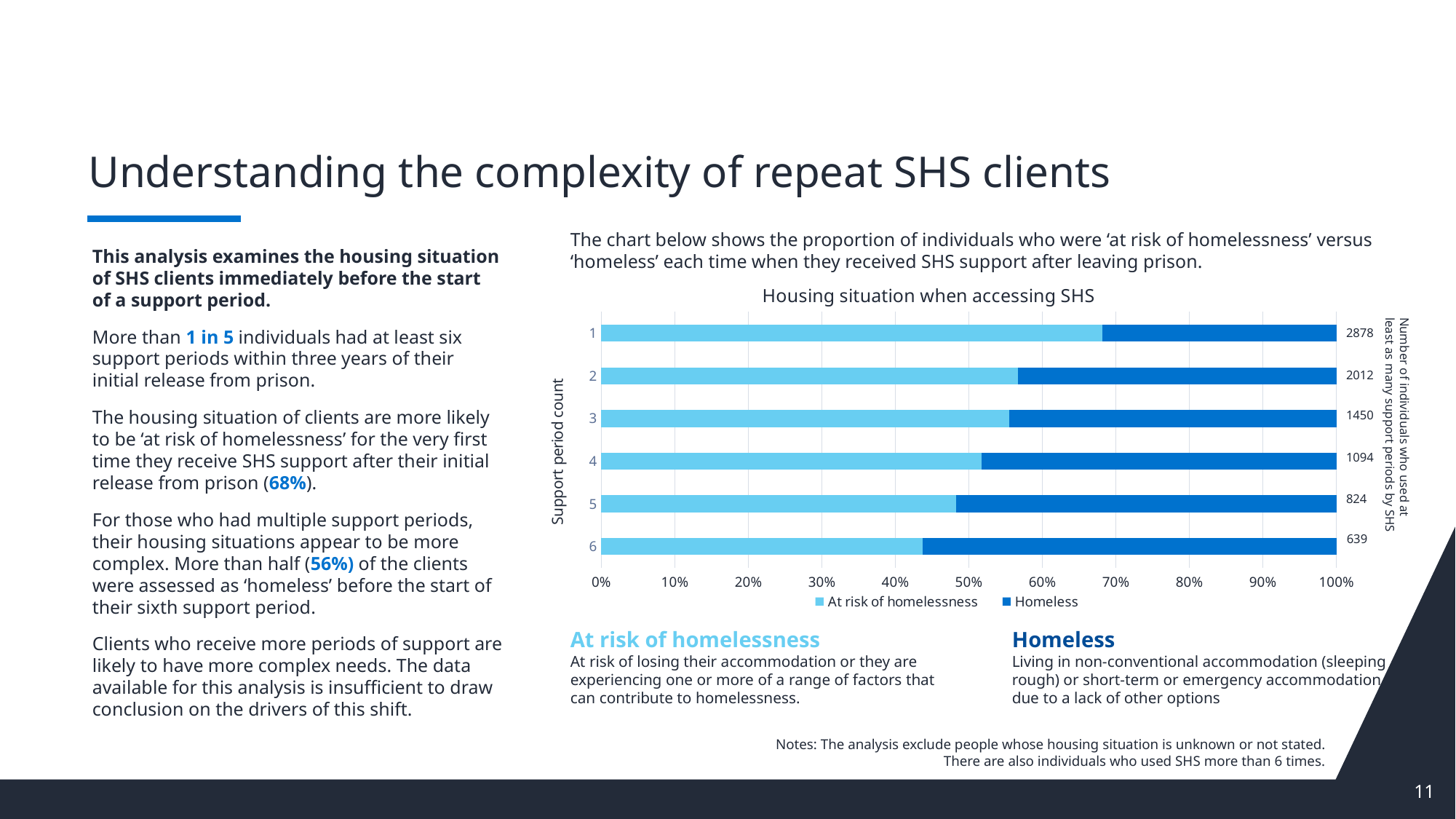
What type of chart is shown on the slide? Stacked bar chart Is the 'At risk of homelessness' share for support period count 1 greater or less than 60%? greater Which support period count has the smallest number of individuals shown on the right of the chart? 6 Is the 'At risk of homelessness' share for support period count 6 greater or less than 50%? less What is the title of the chart? Housing situation when accessing SHS How does the 'At risk of homelessness' share change as the support period count increases from 1 to 6? It falls How many series does the chart legend list? 2 What is the difference between the number of individuals with at least 1 support period and at least 2 support periods? 866 Which is larger for support period count 1: the 'At risk of homelessness' share or the 'Homeless' share? At risk of homelessness According to the labels on the right of the chart, how many individuals used at least 1 support period by SHS? 2878 According to the labels on the right of the chart, how many individuals used at least 4 support periods by SHS? 1094 How many support period count categories are plotted in the chart? 6